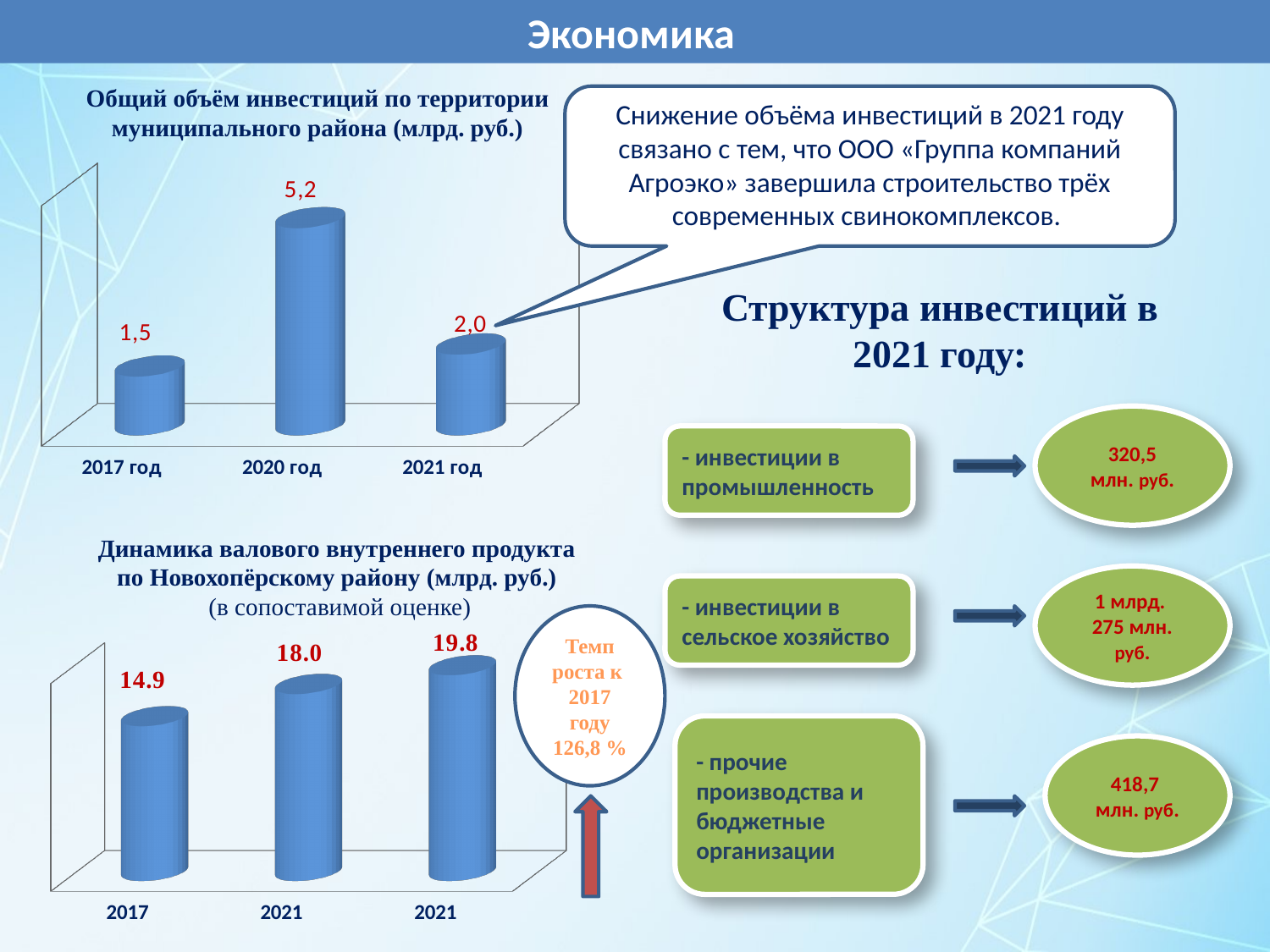
In the chart 'Общий объём инвестиций по территории муниципального района (млрд. руб.)', what is the value for 2021 год? 2,0 In the chart 'Общий объём инвестиций по территории муниципального района (млрд. руб.)', what is the value for 2017 год? 1,5 In the chart 'Динамика валового внутреннего продукта по Новохопёрскому району (млрд. руб.)', what is the value of the rightmost bar? 19.8 In the chart 'Динамика валового внутреннего продукта по Новохопёрскому району (млрд. руб.)', what is the value for 2017? 14.9 How many bars are in the chart 'Общий объём инвестиций по территории муниципального района (млрд. руб.)'? 3 In the chart 'Общий объём инвестиций по территории муниципального района (млрд. руб.)', which year has the lowest value? 2017 год In the chart 'Общий объём инвестиций по территории муниципального района (млрд. руб.)', what is the difference between the values for 2020 год and 2021 год? 3,2 In the chart 'Общий объём инвестиций по территории муниципального района (млрд. руб.)', what is the value for 2020 год? 5,2 In the chart 'Динамика валового внутреннего продукта по Новохопёрскому району (млрд. руб.)', do the values rise or fall from left to right? rise In the chart 'Общий объём инвестиций по территории муниципального района (млрд. руб.)', which year has the highest value? 2020 год In the chart 'Динамика валового внутреннего продукта по Новохопёрскому району (млрд. руб.)', what is the difference between the rightmost bar and the 2017 bar? 4.9 What type of chart is 'Динамика валового внутреннего продукта по Новохопёрскому району (млрд. руб.)'? bar chart